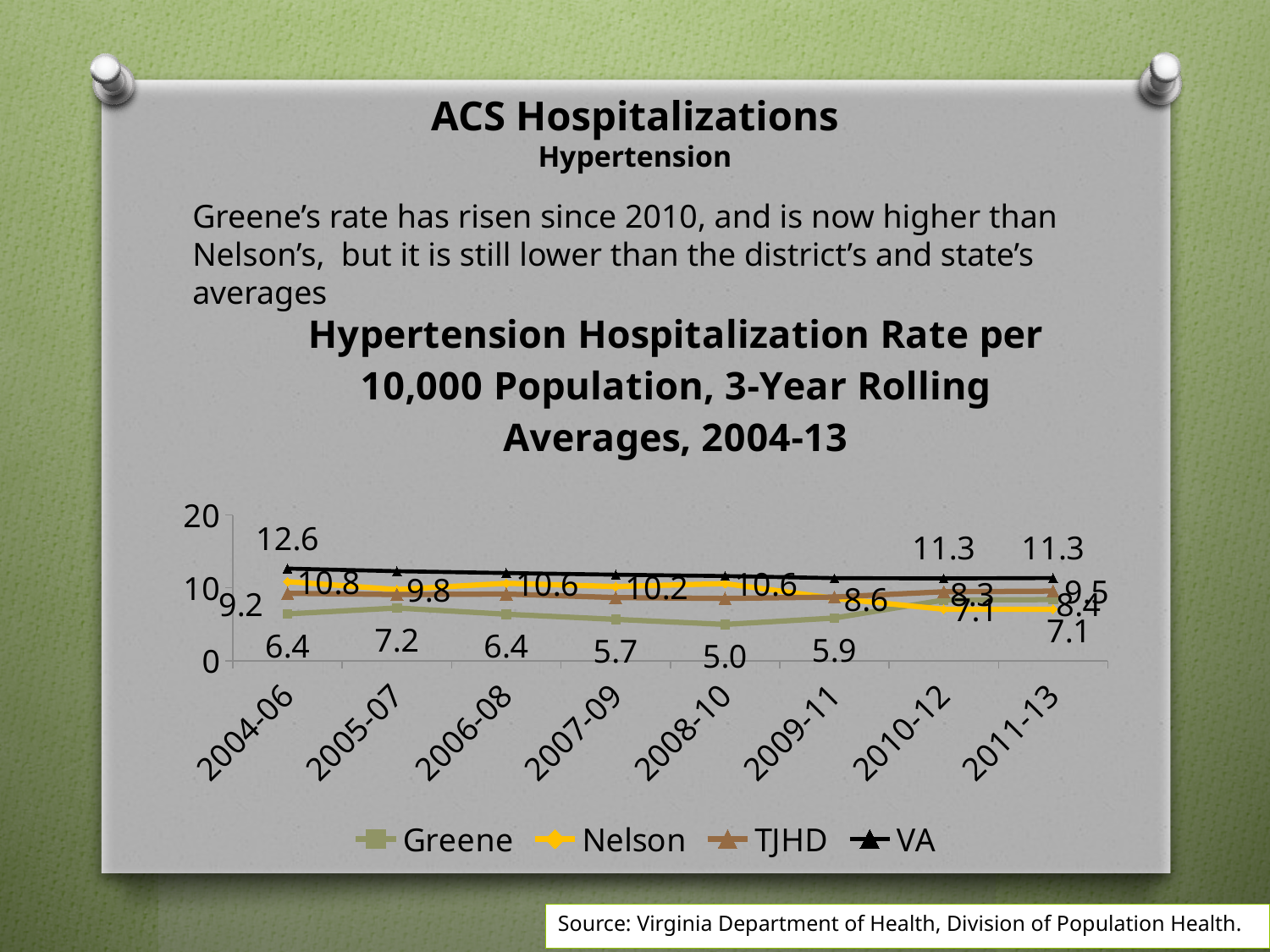
How many time periods are shown on the x axis of the chart? 8 Which series has the highest rate in 2004-06, VA or Greene? VA What is the hypertension hospitalization rate for Greene in 2004-06? 6.4 What is the hypertension hospitalization rate for VA in 2011-13? 11.3 How many series does the chart's legend list? 4 What is the hypertension hospitalization rate for VA in 2004-06? 12.6 What is the difference between Greene's rate in 2005-07 and in 2008-10? 2.2 What is the difference between VA's rate in 2004-06 and in 2010-12? 1.3 What is the hypertension hospitalization rate for Greene in 2008-10? 5.0 In which period is Greene's rate lowest? 2008-10 What type of chart is shown on the slide? line chart Is the value for VA in 2007-09 greater or less than 10? greater